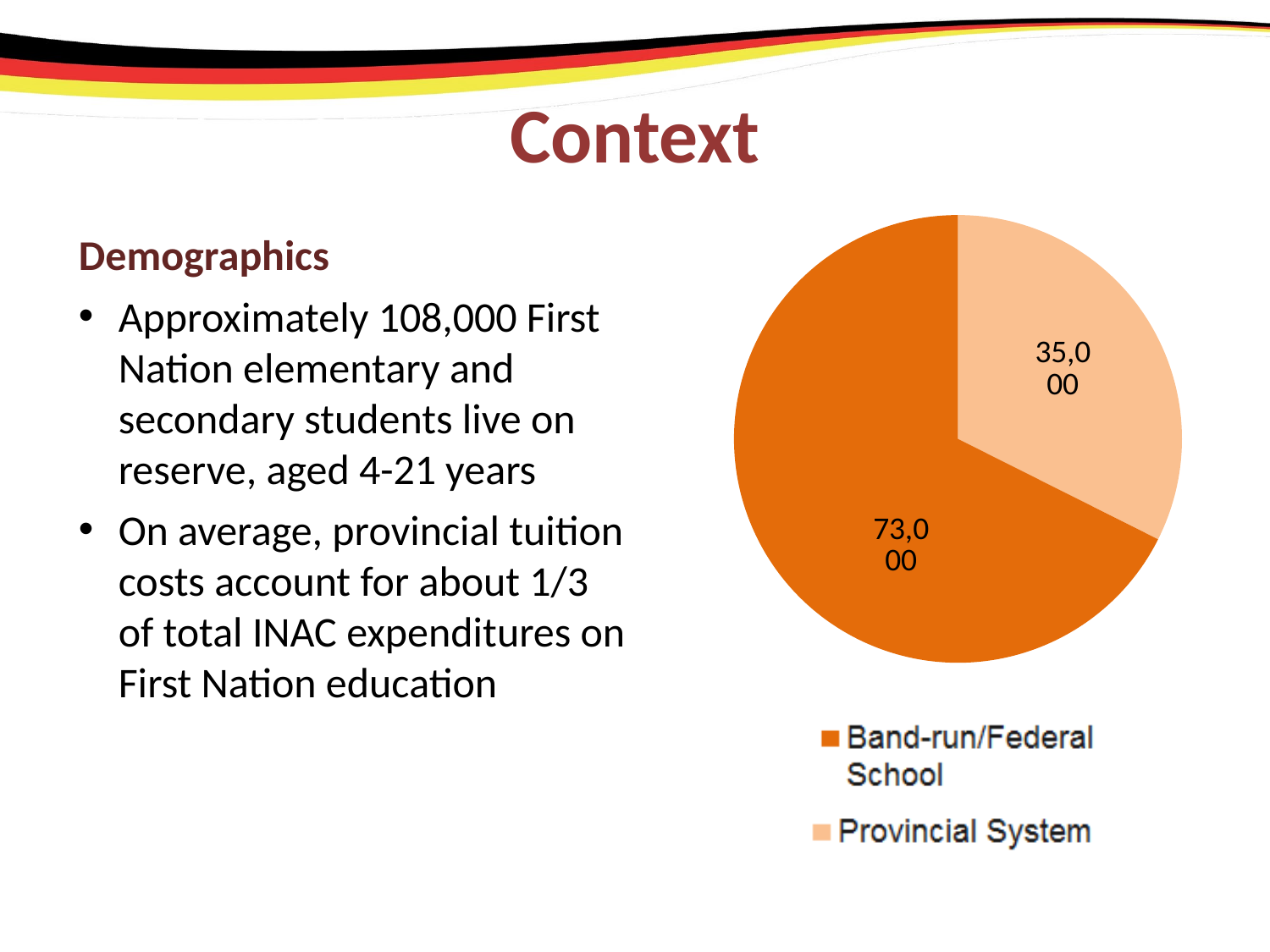
How many entries does the legend of the pie chart list? 2 What is the total of the two values shown in the pie chart? 108,000 What is the difference between the Band-run/Federal School value and the Provincial System value? 38,000 Which is larger, the value for Band-run/Federal School or the value for Provincial System? Band-run/Federal School What is the value for Provincial System in the pie chart? 35,000 What type of chart is shown on the slide? pie chart How many slices does the pie chart have? 2 What share of the pie does the Provincial System slice represent? 32.4% Which category has the smallest slice in the pie chart? Provincial System Which category has the largest slice in the pie chart? Band-run/Federal School What is the value for Band-run/Federal School in the pie chart? 73,000 Which legend entry is shown in the lighter orange colour? Provincial System